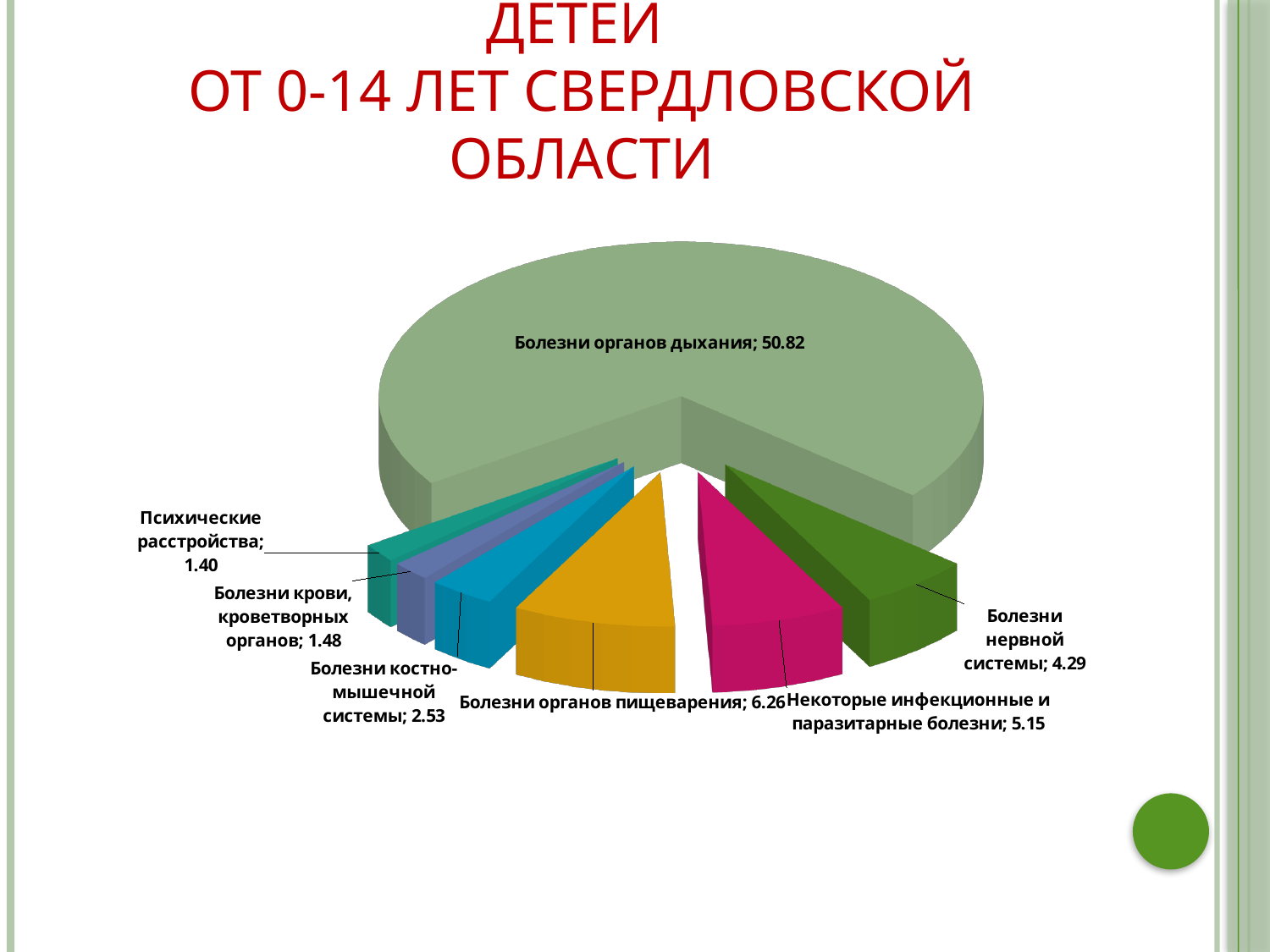
What is the difference between the values for Болезни органов пищеварения and Некоторые инфекционные и паразитарные болезни? 1.11 Which is larger: the value for Болезни нервной системы or the value for Болезни костно-мышечной системы? Болезни нервной системы Which category has the smallest slice of the pie? Психические расстройства What is the value for Болезни органов пищеварения? 6.26 What kind of chart is shown on the slide? Pie chart How many slices are labelled in the pie chart? 7 What is the value for Болезни нервной системы? 4.29 Which category has the largest slice of the pie? Болезни органов дыхания What is the value for Болезни органов дыхания? 50.82 What is the value for Психические расстройства? 1.40 What is the value for Болезни костно-мышечной системы? 2.53 What is the value for Некоторые инфекционные и паразитарные болезни? 5.15